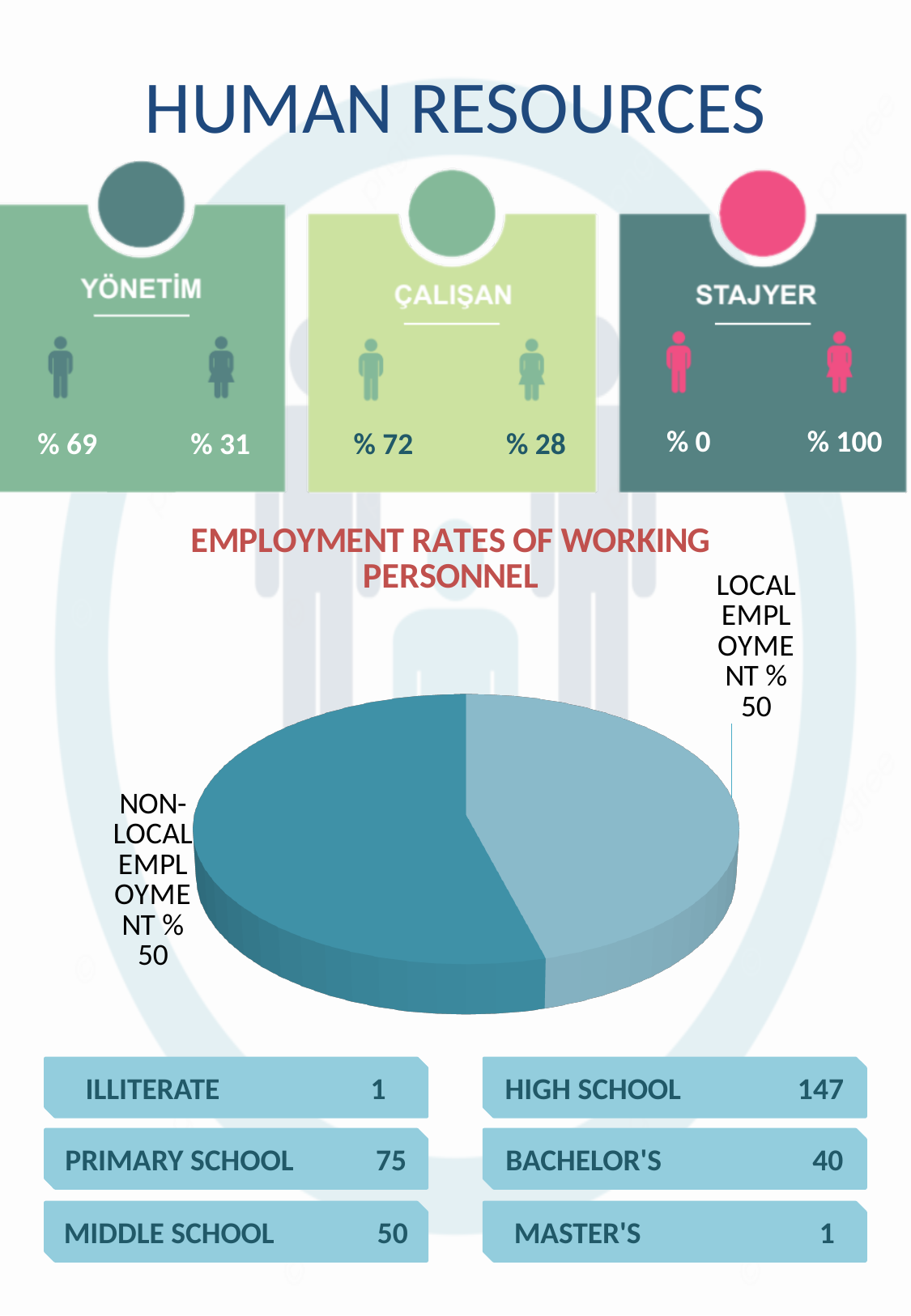
What kind of chart is shown under the title 'EMPLOYMENT RATES OF WORKING PERSONNEL'? pie chart Which slice of the pie chart is drawn in the darker blue shade? NON-LOCAL EMPLOYMENT How many slices does the 'EMPLOYMENT RATES OF WORKING PERSONNEL' pie chart have? 2 What is the difference between the labelled values for LOCAL EMPLOYMENT and NON-LOCAL EMPLOYMENT in the pie chart? 0 In the 'EMPLOYMENT RATES OF WORKING PERSONNEL' pie chart, what value is labelled for LOCAL EMPLOYMENT? % 50 What do the two labelled slice values in the 'EMPLOYMENT RATES OF WORKING PERSONNEL' pie chart add up to? 100 What is the title of the pie chart on the slide? EMPLOYMENT RATES OF WORKING PERSONNEL In the 'EMPLOYMENT RATES OF WORKING PERSONNEL' pie chart, what value is labelled for NON-LOCAL EMPLOYMENT? % 50